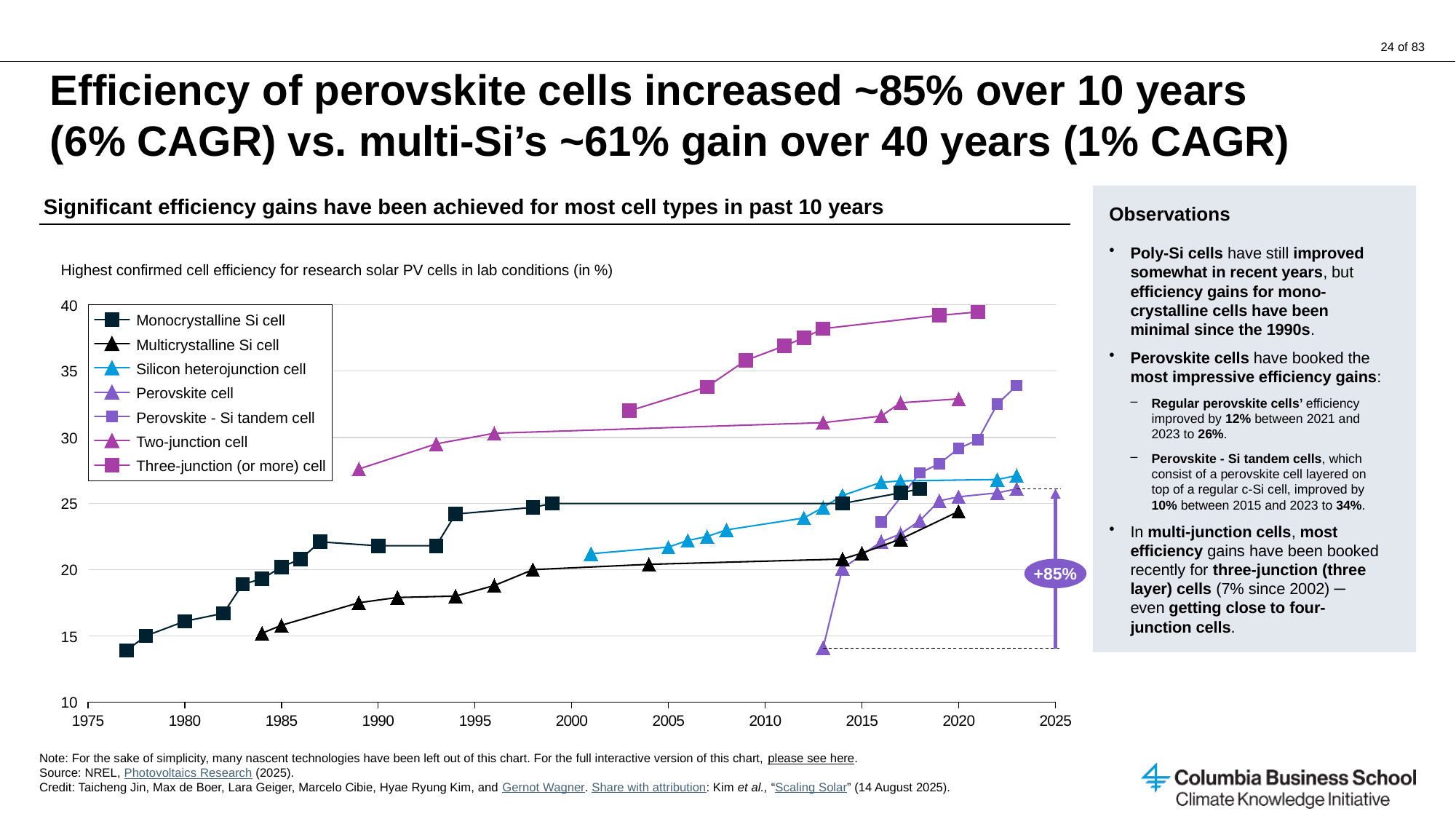
What kind of chart is shown on the slide? Line chart In 2023, which is higher: the Perovskite - Si tandem cell or the Perovskite cell? Perovskite - Si tandem cell What percentage gain is shown by the annotation next to the Perovskite cell line? +85% Does the efficiency of the Monocrystalline Si cell rise or fall from 1977 to 2018? Rise Is the value for the Three-junction (or more) cell in 2021 greater or less than 35? greater How many series does the chart's legend list? 7 Which series reaches the highest efficiency on the chart? Three-junction (or more) cell Is the value for the Multicrystalline Si cell in 1984 greater or less than 20? less Is the value for the Perovskite - Si tandem cell in 2023 greater or less than 30? greater What is the highest value shown on the chart's y-axis? 40